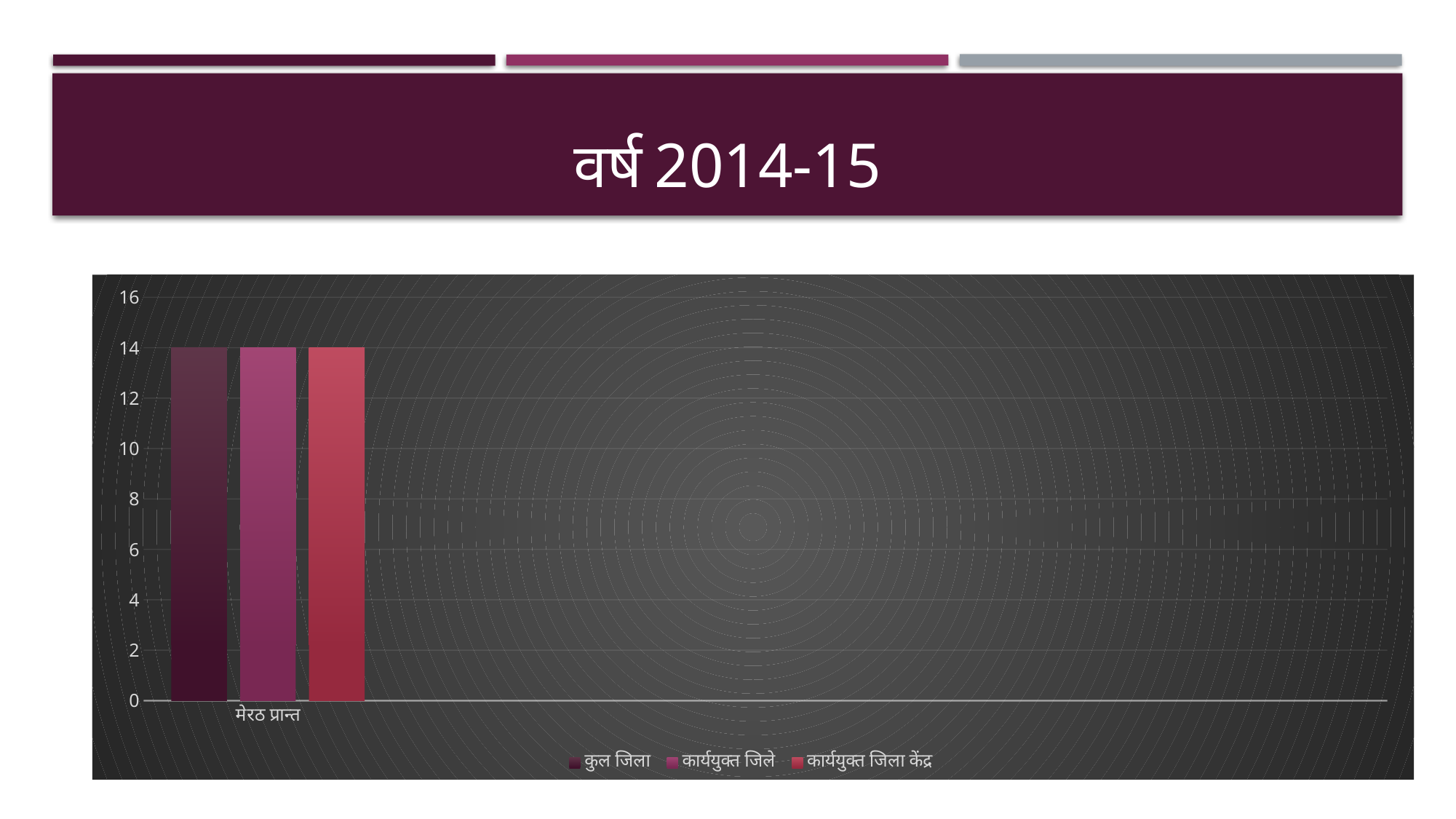
What is the difference between कुल जिला and कार्ययुक्त जिले for मेरठ प्रान्त? 0 What is the value of कार्ययुक्त जिला केंद्र for मेरठ प्रान्त? 14 What is the value of कार्ययुक्त जिले for मेरठ प्रान्त? 14 What is the name of the only category on the x axis of the chart? मेरठ प्रान्त Is the value of कार्ययुक्त जिला केंद्र for मेरठ प्रान्त greater or less than 16? less How many series does the chart legend list? 3 What is the title shown on the slide above the chart? वर्ष 2014-15 How many categories are shown on the x axis of the chart? 1 What kind of chart is shown on the slide? bar chart What is the highest value shown on the chart's y axis? 16 What is the value of कुल जिला for मेरठ प्रान्त? 14 Is the value of कुल जिला for मेरठ प्रान्त greater or less than 10? greater